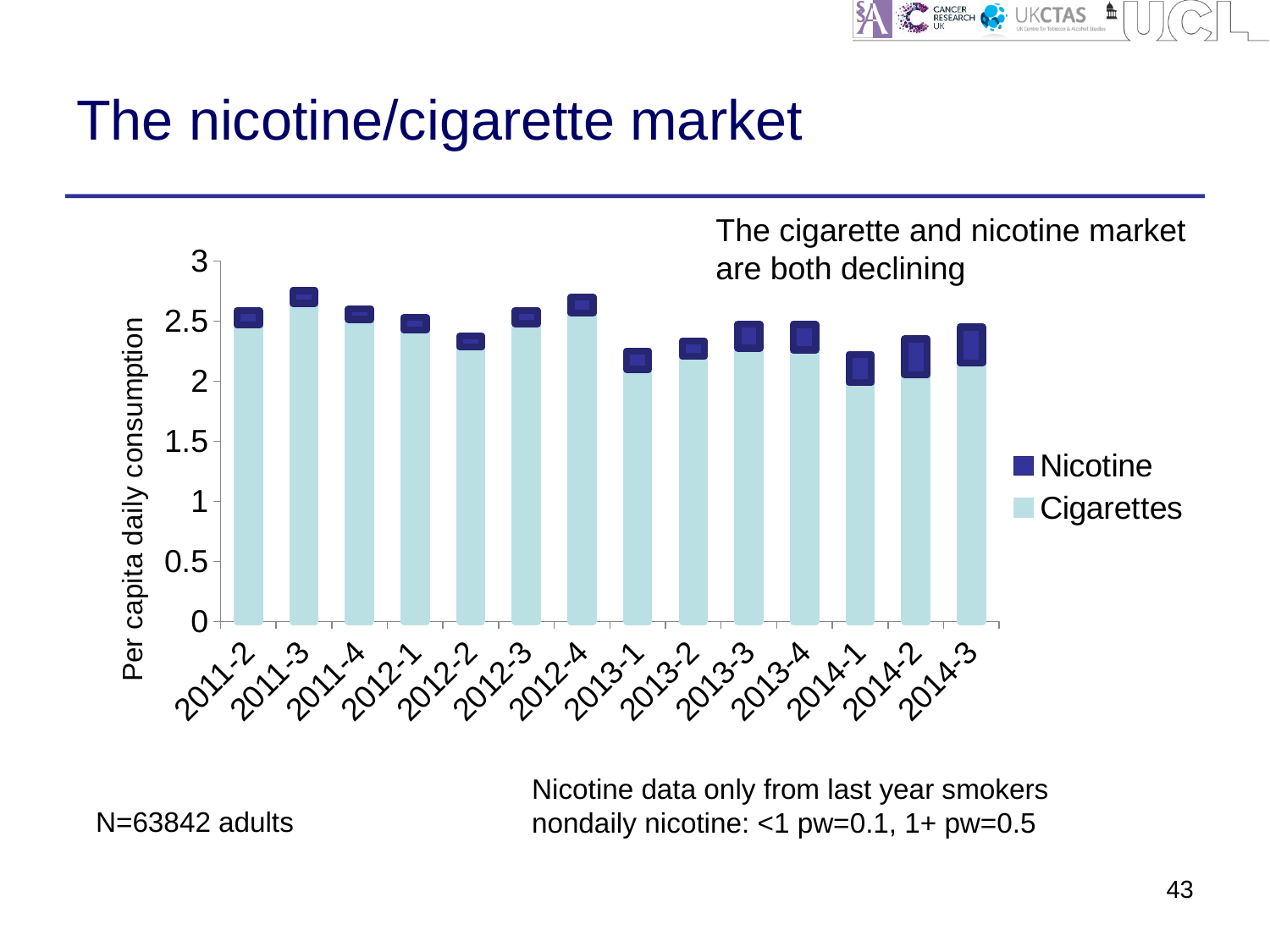
Is the Cigarettes value larger in 2011-3 or in 2014-1? 2011-3 Which quarter has the highest Cigarettes value? 2011-3 Does the Cigarettes value generally rise or fall from 2011-2 to 2014-3? fall What is the label of the vertical axis of the chart? Per capita daily consumption Is the total stacked value for 2014-1 greater or less than 2.5? less What kind of chart is shown on the slide? Stacked bar chart Is the Cigarettes value for 2011-3 greater or less than 2.5? greater Is the Cigarettes value for 2013-1 greater or less than 2.5? less How many quarterly categories are shown on the x axis of the chart? 14 Which two series are listed in the chart legend? Nicotine and Cigarettes How many series does the chart legend list? 2